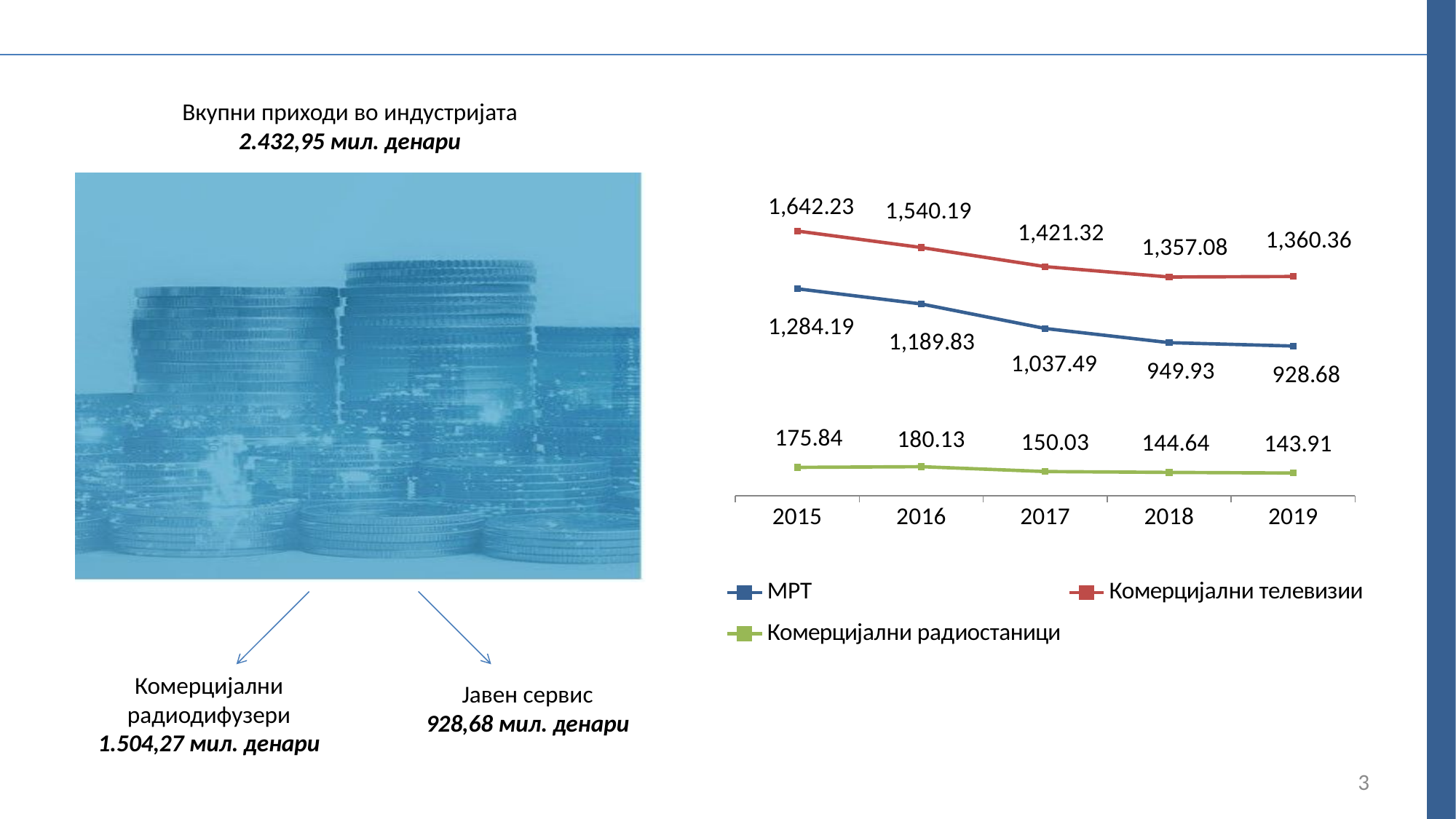
What is the value for Комерцијални телевизии in 2015? 1,642.23 What kind of chart is shown on the slide? Line chart Which series has the larger value in 2018, МРТ or Комерцијални радиостаници? МРТ How many series does the chart legend list? 3 In which year is the value for Комерцијални радиостаници the highest? 2016 What is the value for МРТ in 2017? 1,037.49 How many years are shown on the x axis of the chart? 5 Which series is drawn in red on the chart? Комерцијални телевизии Does the value for МРТ rise or fall from 2015 to 2019? Fall What is the value for Комерцијални радиостаници in 2019? 143.91 What is the difference between the Комерцијални телевизии value and the МРТ value in 2019? 431.68 In which year is the value for МРТ the lowest? 2019